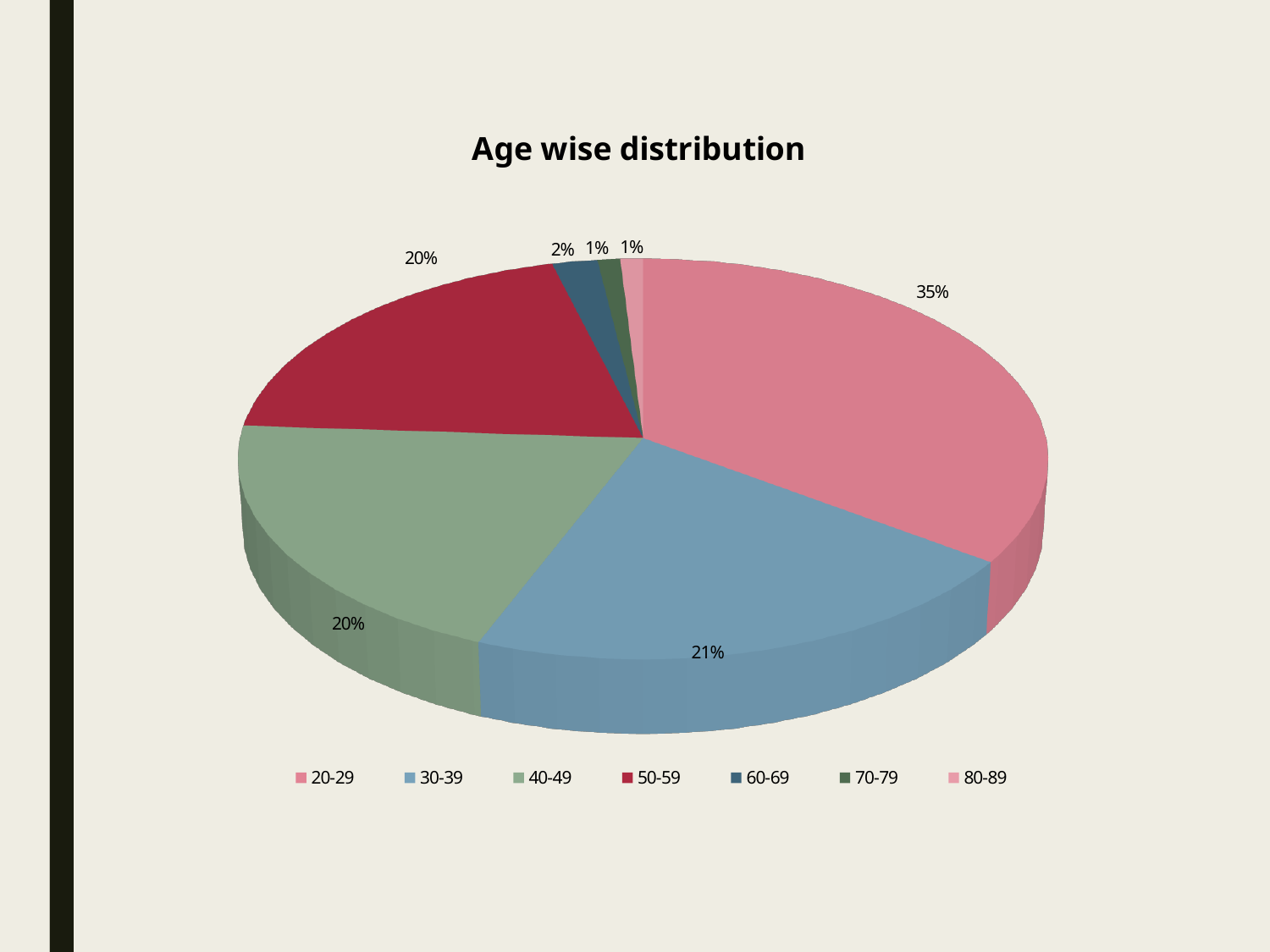
Which age group has the largest share of the pie? 20-29 What percentage is shown for the 50-59 age group? 20% What type of chart is shown on the slide? Pie chart What is the difference in percentage points between the 20-29 and 30-39 age groups? 14 Which is larger, the share for 30-39 or the share for 60-69? 30-39 What is the combined share of the 70-79 and 80-89 age groups? 2% What percentage is shown for the 60-69 age group? 2% How many age groups does the legend list? 7 What share of the pie does the 30-39 age group represent? 21% What percentage is shown for the 40-49 age group? 20% What is the title of the chart? Age wise distribution What share of the pie does the 20-29 age group represent? 35%